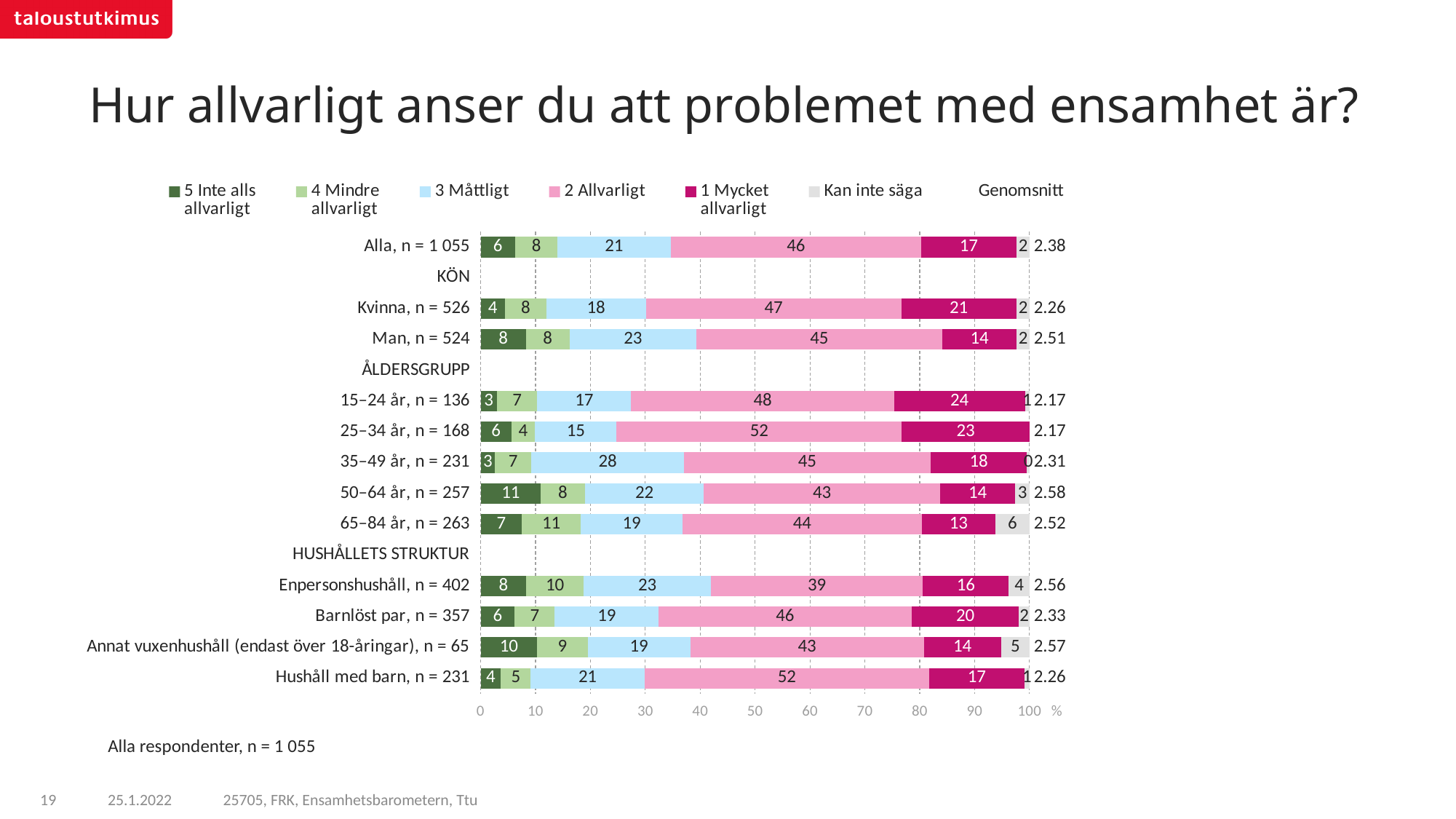
How many respondent groups have bars plotted in the chart? 12 What percentage of the 35–49 år group answered "3 Måttligt"? 28 What is the Genomsnitt (average) value shown for Man, n = 524? 2.51 What percentage of the 15–24 år group answered "1 Mycket allvarligt"? 24 What is the difference in the "1 Mycket allvarligt" share between Kvinna and Man? 7 Which group has the highest share of "5 Inte alls allvarligt" responses? 50–64 år, n = 257 What type of chart is shown on the slide? Stacked bar chart What percentage of all respondents (Alla, n = 1 055) answered "2 Allvarligt"? 46 Which group has the highest Genomsnitt value? 50–64 år, n = 257 Which has a larger "2 Allvarligt" share, Kvinna or Man? Kvinna How many entries does the legend list? 7 Which group has the highest share of "1 Mycket allvarligt" responses? 15–24 år, n = 136